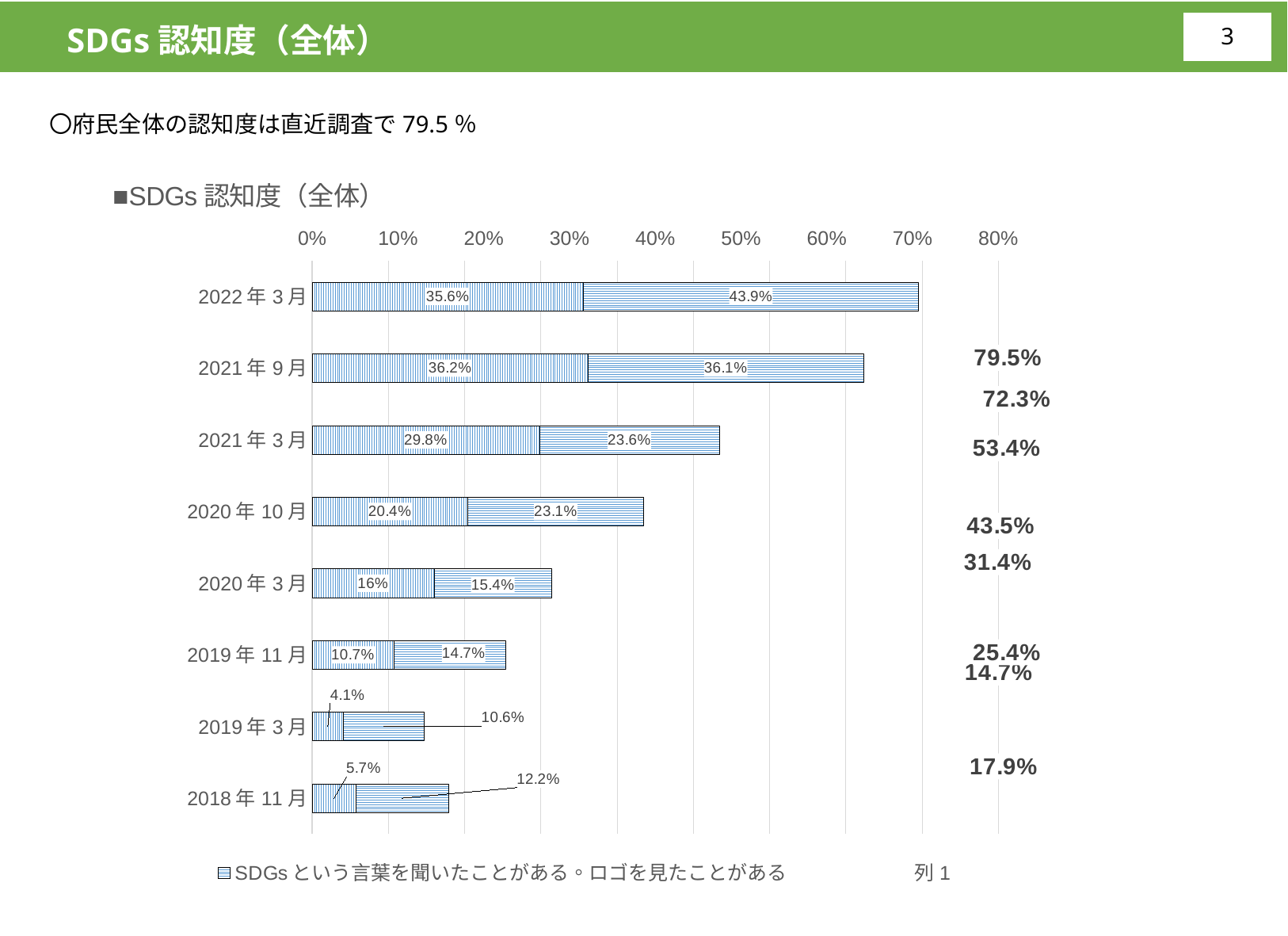
Which survey period has the longest total bar? 2022年3月 How many survey periods are shown on the chart? 8 What kind of chart is shown on the slide? Stacked bar chart What is the difference between the 'ロゴを見たことがある' values for 2022年3月 and 2021年9月? 7.8 percentage points Which survey period has the shortest total bar? 2019年3月 What is the total of the stacked bar for 2021年3月? 53.4% Do the total bar lengths rise or fall from 2019年3月 to 2022年3月? Rise What is the value of the 'ロゴを見たことがある' segment for 2022年3月? 43.9% What is the value of the 'ロゴを見たことがある' segment for 2021年9月? 36.1%